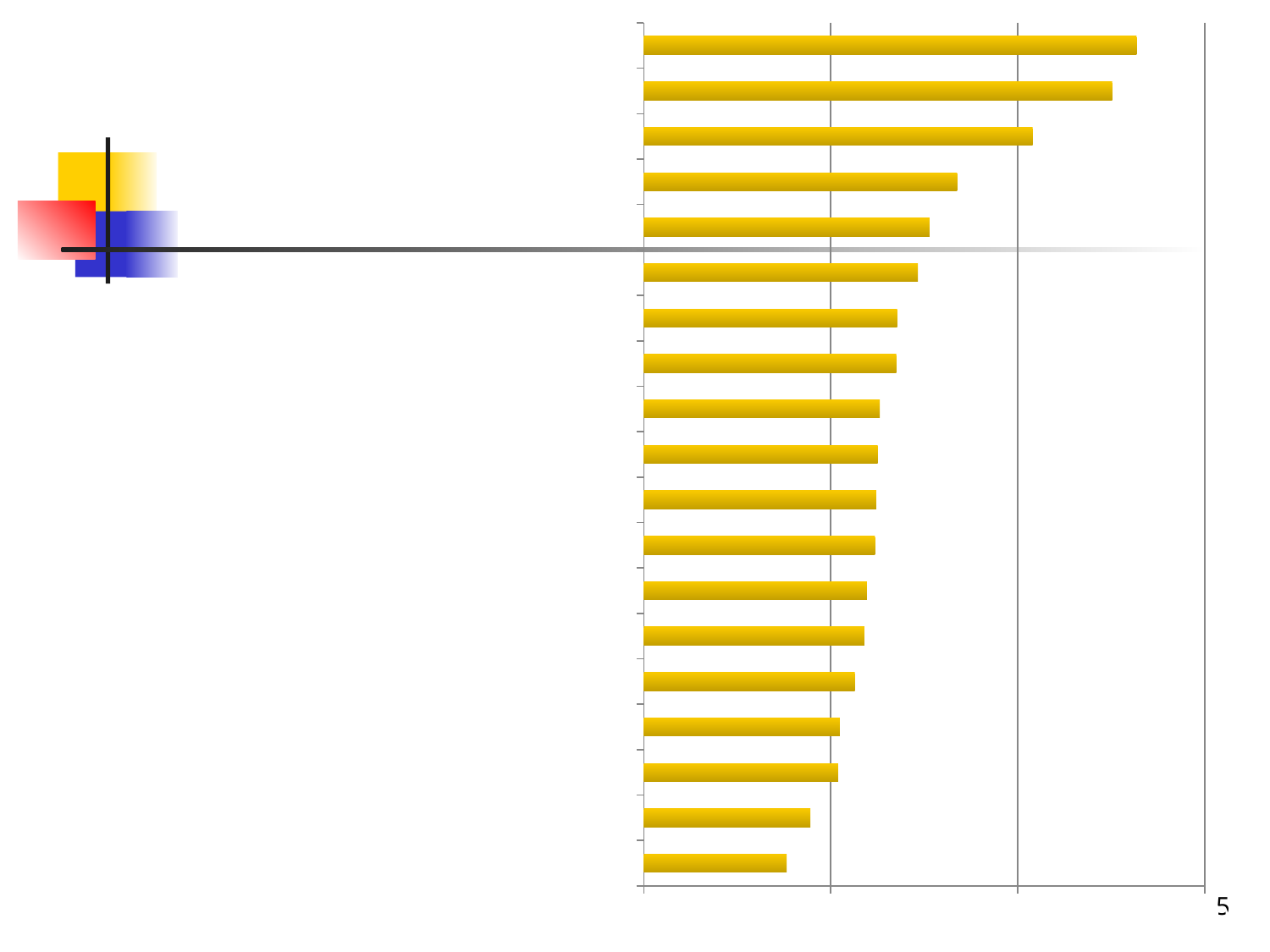
What colour are the bars in the chart? yellow Are the bars in the chart drawn horizontally or vertically? horizontally How many bars are plotted in the chart? 19 What kind of chart is shown on the slide? bar chart Do the bars get longer or shorter going from the top of the chart to the bottom? shorter